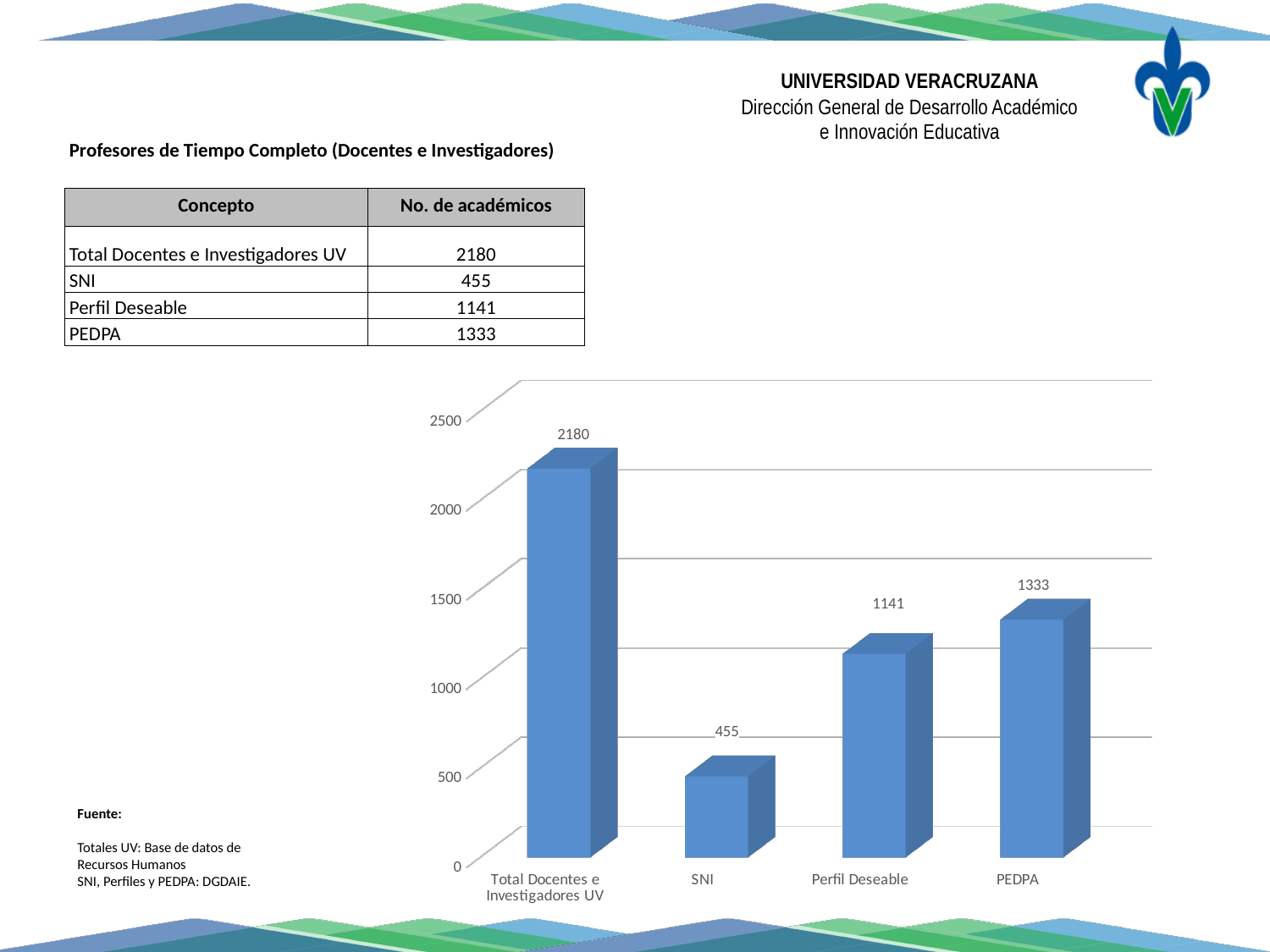
What is the value for Total Docentes e Investigadores UV in the chart? 2180 What is the value for Perfil Deseable in the chart? 1141 Which category has the lowest value in the chart? SNI How many categories are shown on the x axis of the chart? 4 What is the value for PEDPA in the chart? 1333 What is the difference between the values for Total Docentes e Investigadores UV and SNI? 1725 Is the value for SNI greater or less than 500? less What is the value for SNI in the chart? 455 Which category has the highest value in the chart? Total Docentes e Investigadores UV Which is larger, the value for PEDPA or the value for Perfil Deseable? PEDPA What is the difference between the values for PEDPA and Perfil Deseable? 192 What kind of chart is shown on the slide? bar chart